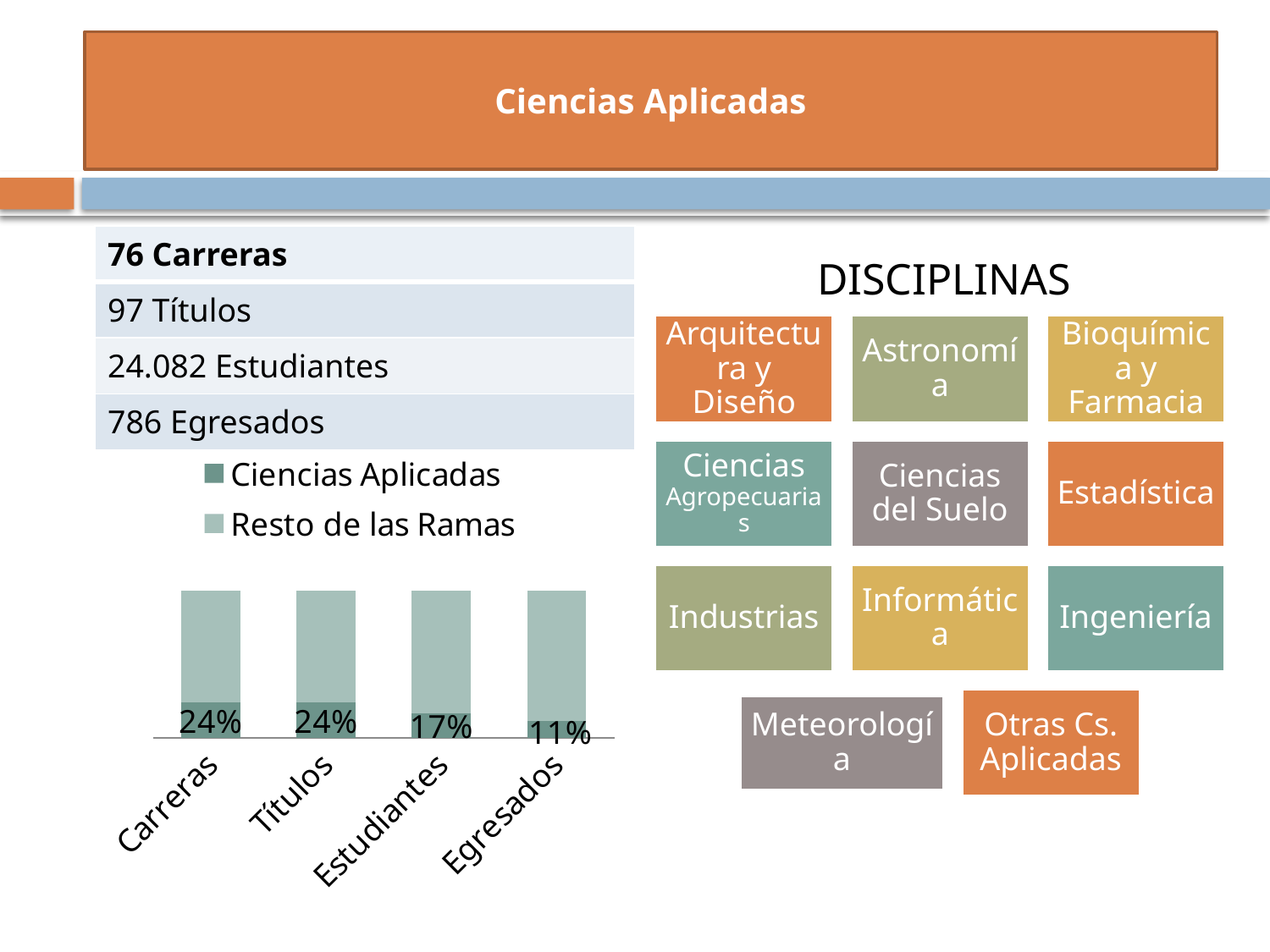
What is the Ciencias Aplicadas share for Estudiantes? 17% What is the Ciencias Aplicadas share for Títulos? 24% How many categories are shown on the x axis of the chart? 4 What is the Ciencias Aplicadas share for Egresados? 11% Does the Ciencias Aplicadas share rise or fall from Títulos to Egresados? Fall What kind of chart is shown on the slide? Stacked bar chart What is the difference in percentage points between the Ciencias Aplicadas share for Carreras and for Egresados? 13 percentage points Which category has the lowest Ciencias Aplicadas share? Egresados What is the Ciencias Aplicadas share for Carreras? 24% What is the difference in percentage points between the Ciencias Aplicadas share for Estudiantes and for Egresados? 6 percentage points How many series does the chart legend list? 2 Which has a larger Ciencias Aplicadas share, Estudiantes or Egresados? Estudiantes